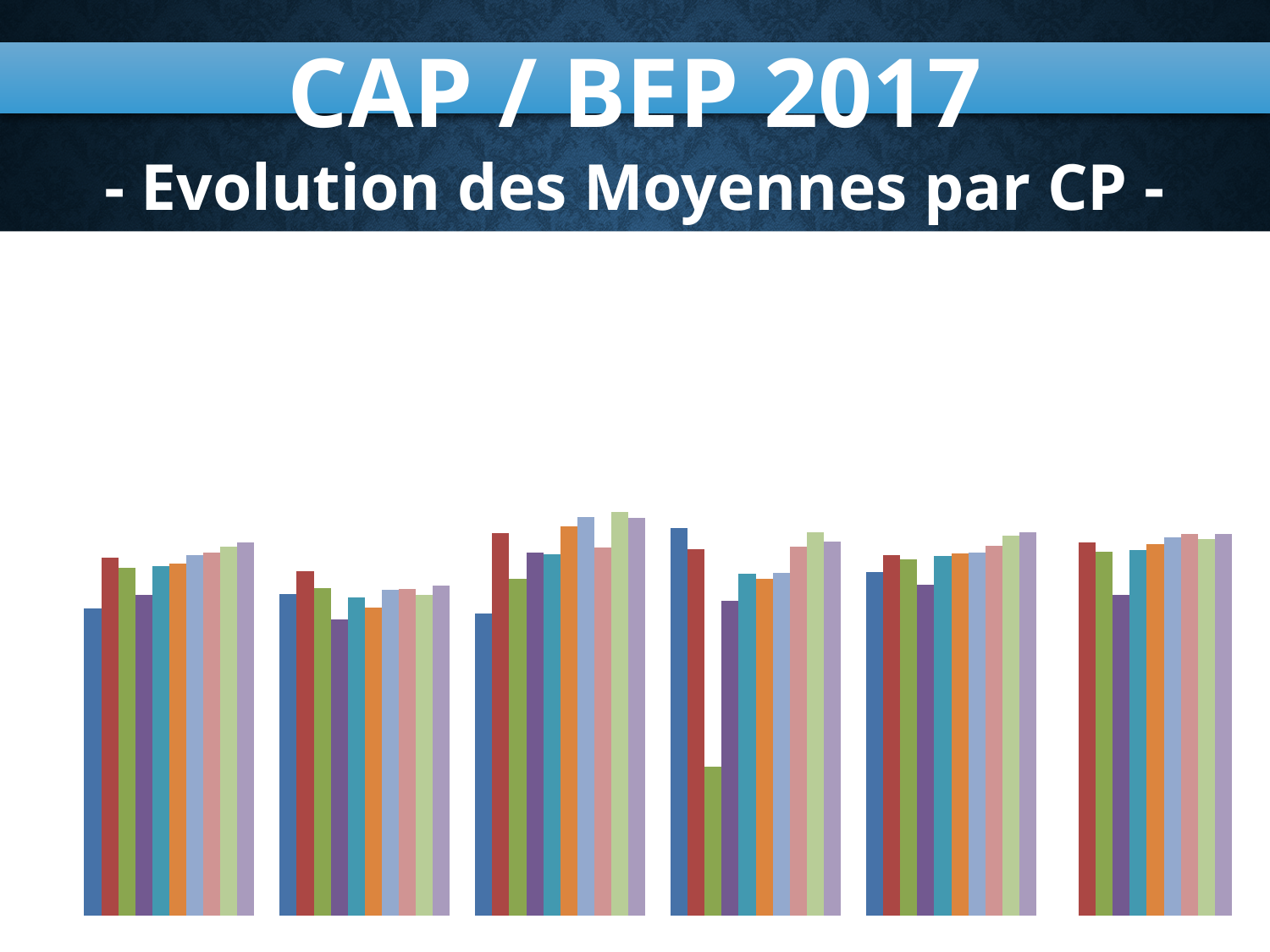
How many groups of bars does the chart contain? 6 Which group of bars, counting from the left, contains the shortest bar on the chart? the fourth group What kind of chart is shown on the slide? bar chart What colour is the shortest bar on the chart? green What is the main title shown at the top of the slide? CAP / BEP 2017 In the fifth group from the left, is the first (dark blue) bar taller or shorter than the green bar? shorter How many bars are there in each group of the chart? 10 In the first group from the left, is the first (dark blue) bar taller or shorter than the second (red) bar? shorter In the second group from the left, which colour bar is the shortest? purple What is the subtitle shown below the main title of the slide? - Evolution des Moyennes par CP -